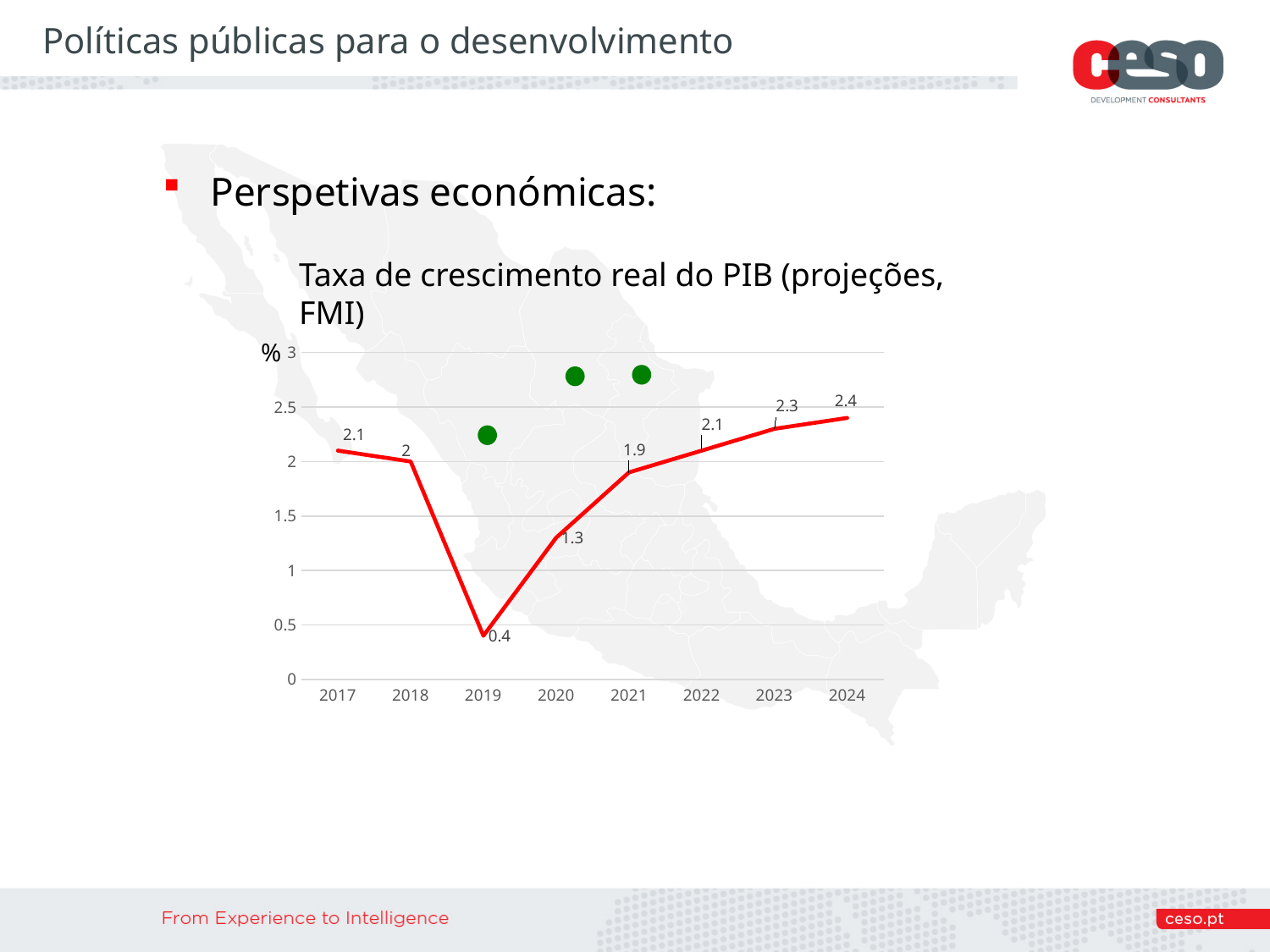
Which year has the lowest value? 2019 What is the difference between the values for 2024 and 2019? 2 What is the value for 2019? 0.4 What is the value for 2021? 1.9 Which year has the highest value? 2024 Which is larger, the value for 2017 or the value for 2020? 2017 How many years are plotted on the x axis? 8 Is the value for 2022 greater or less than 1.5? greater Do the values rise or fall from 2019 to 2024? rise What is the value for 2024? 2.4 What kind of chart is shown? line chart What is the title of the chart? Taxa de crescimento real do PIB (projeções, FMI)